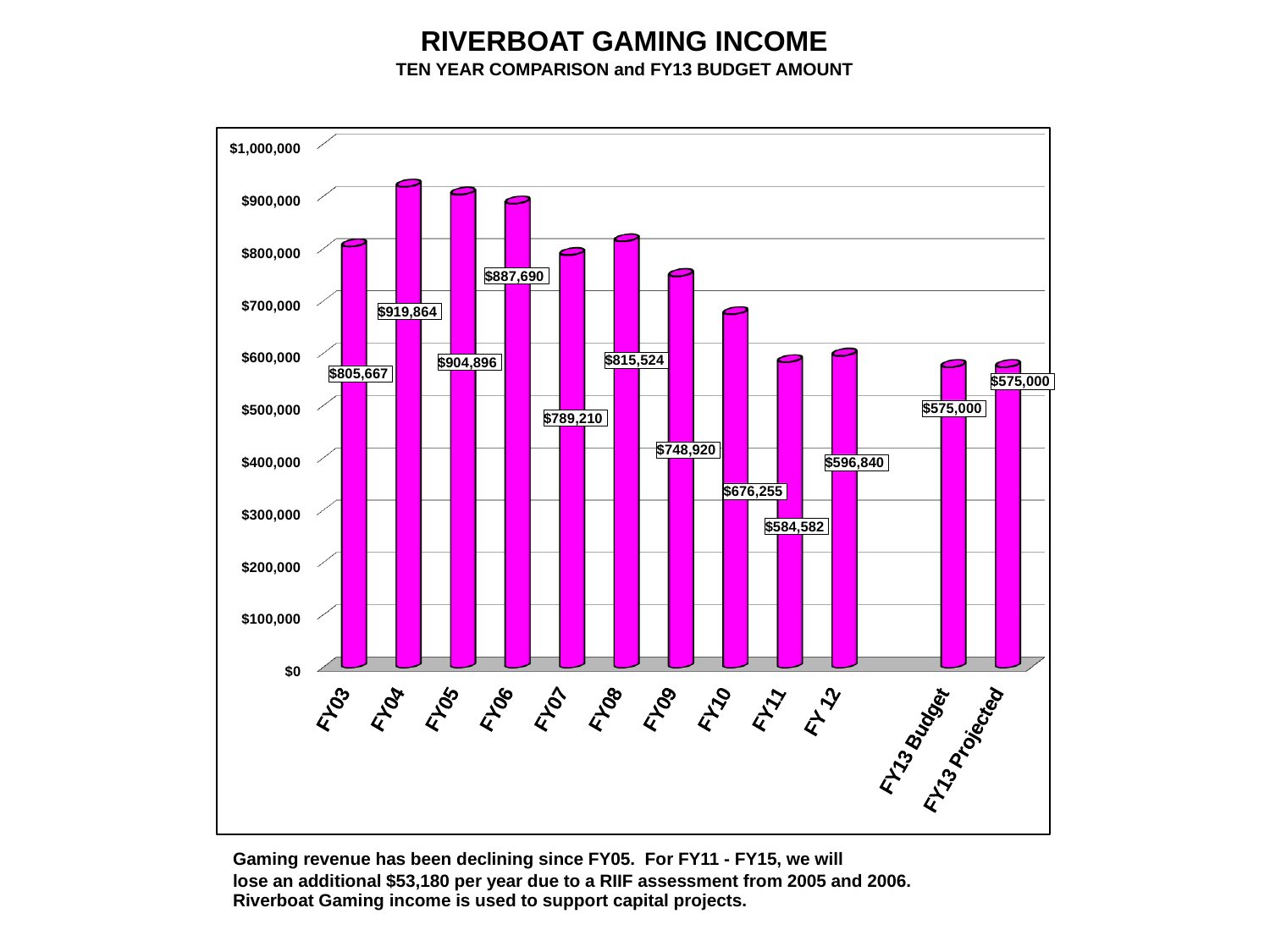
What is the riverboat gaming income for FY07? $789,210 What is the FY13 Budget amount? $575,000 Is the value for FY09 greater or less than $700,000? greater How many bars are shown in the chart? 12 How much higher is the FY03 income than the FY13 Projected amount? $230,667 Which is larger, the income for FY11 or FY 12? FY 12 Among FY03 through FY 12, which fiscal year has the lowest riverboat gaming income? FY11 Which fiscal year has the highest riverboat gaming income? FY04 What is the difference between the FY04 and FY05 riverboat gaming income? $14,968 What type of chart is shown on the slide? Bar chart What is the riverboat gaming income for FY10? $676,255 What is the riverboat gaming income for FY04? $919,864